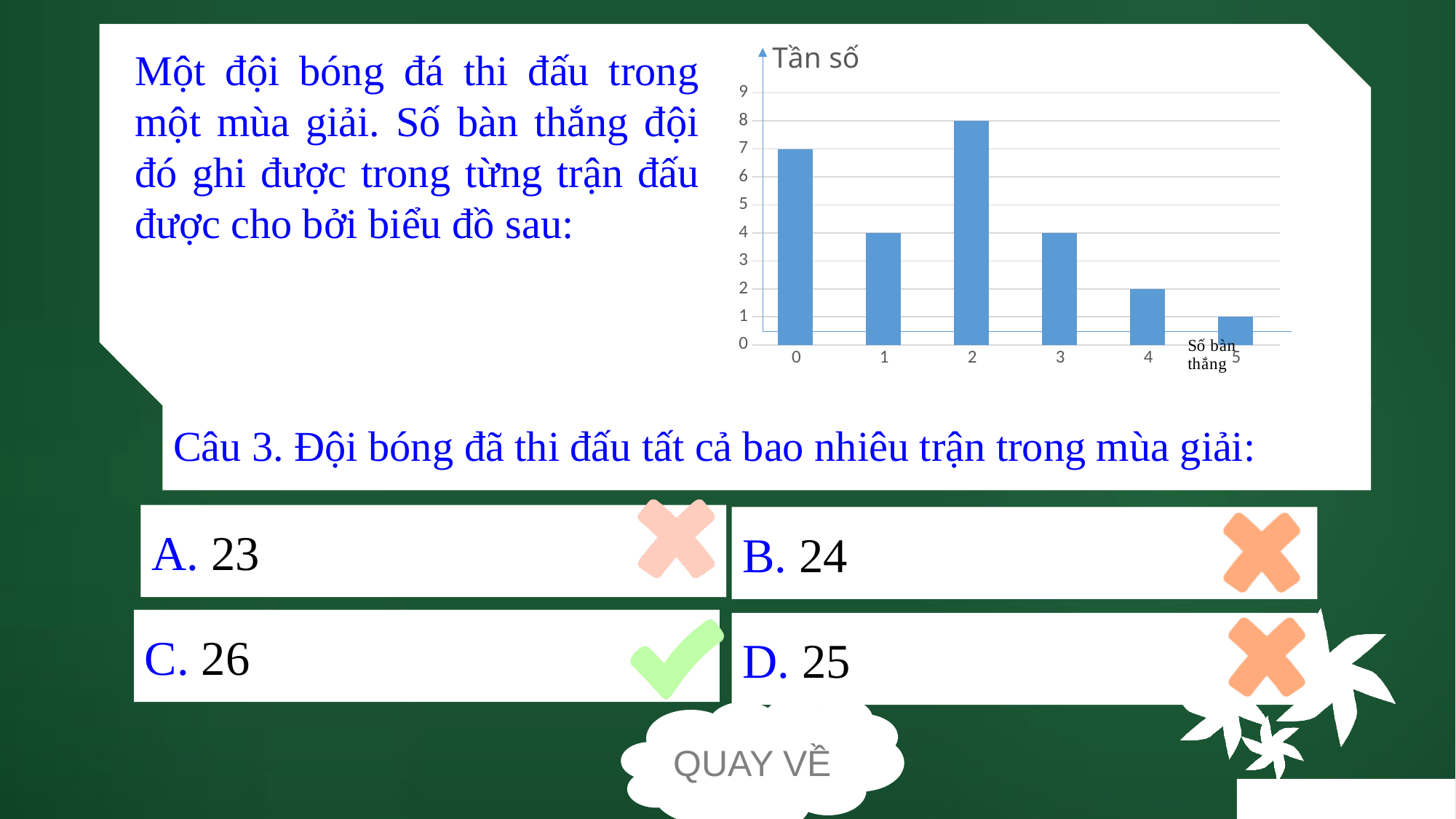
Which number of goals has the highest frequency? 2 What is the frequency for 2 goals? 8 What kind of chart is shown on the slide? bar chart What is the frequency for 4 goals? 2 Is the frequency for 3 goals greater or less than 5? less What is the label of the vertical axis of the chart? Tần số What is the difference between the frequency for 2 goals and the frequency for 0 goals? 1 Which number of goals has the lowest frequency? 5 What is the frequency (Tần số) for 0 goals (Số bàn thắng = 0)? 7 What is the frequency for 5 goals? 1 How many bars (categories) does the chart show? 6 Which has a higher frequency: 1 goal or 4 goals? 1 goal